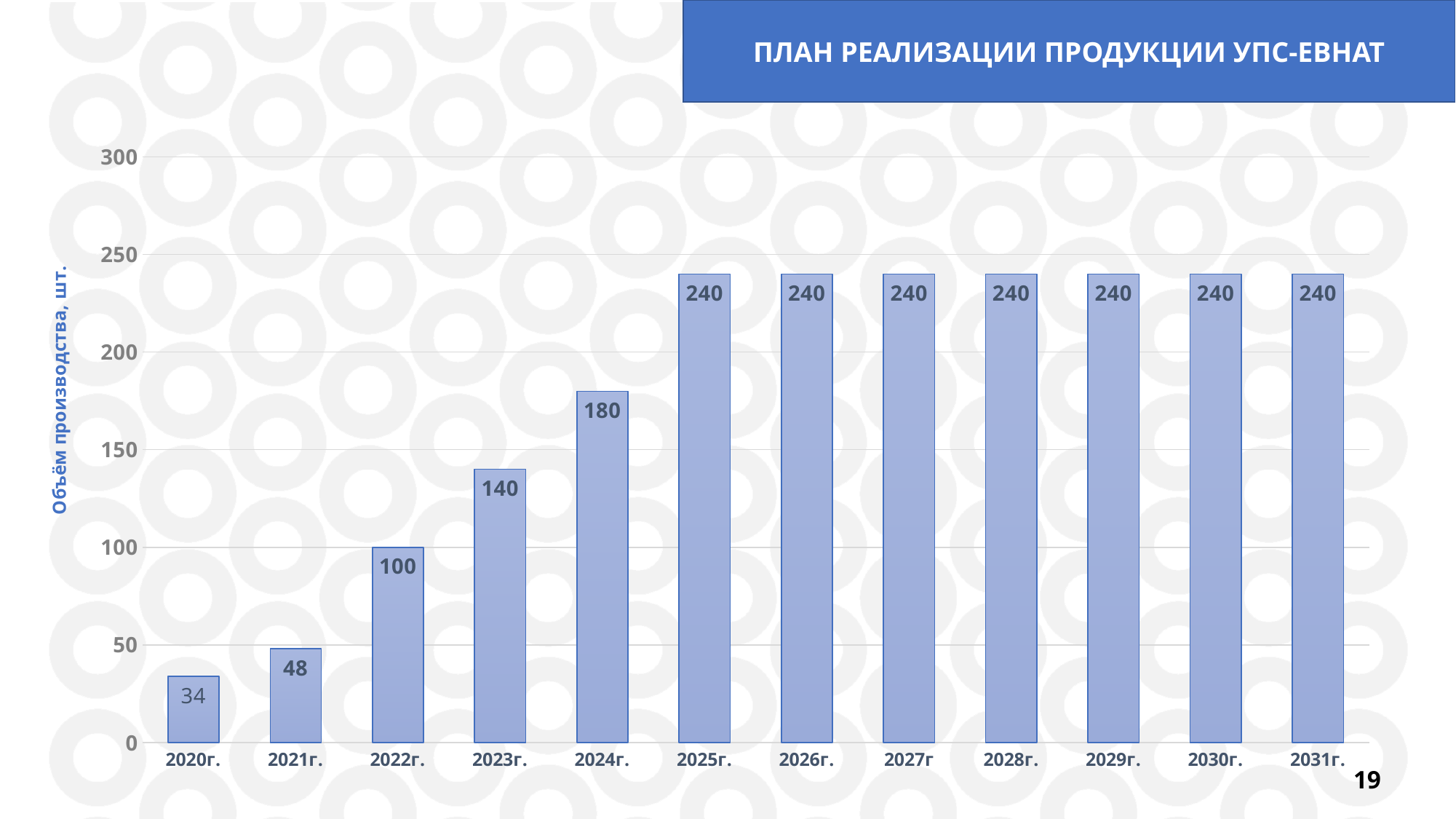
Which is larger, the value for 2023г. or the value for 2022г.? 2023г. What is the value for 2024г.? 180 What is the difference between the values for 2022г. and 2021г.? 52 What kind of chart is shown on the slide? bar chart What is the value for 2023г.? 140 How many years are shown on the x axis? 12 Is the value for 2024г. greater or less than 150? greater What is the title of the chart? ПЛАН РЕАЛИЗАЦИИ ПРОДУКЦИИ УПС-ЕВНАТ What is the value for 2020г.? 34 Which year has the lowest value? 2020г. What is the difference between the values for 2025г. and 2024г.? 60 Do the values rise or fall from 2020г. to 2025г.? rise